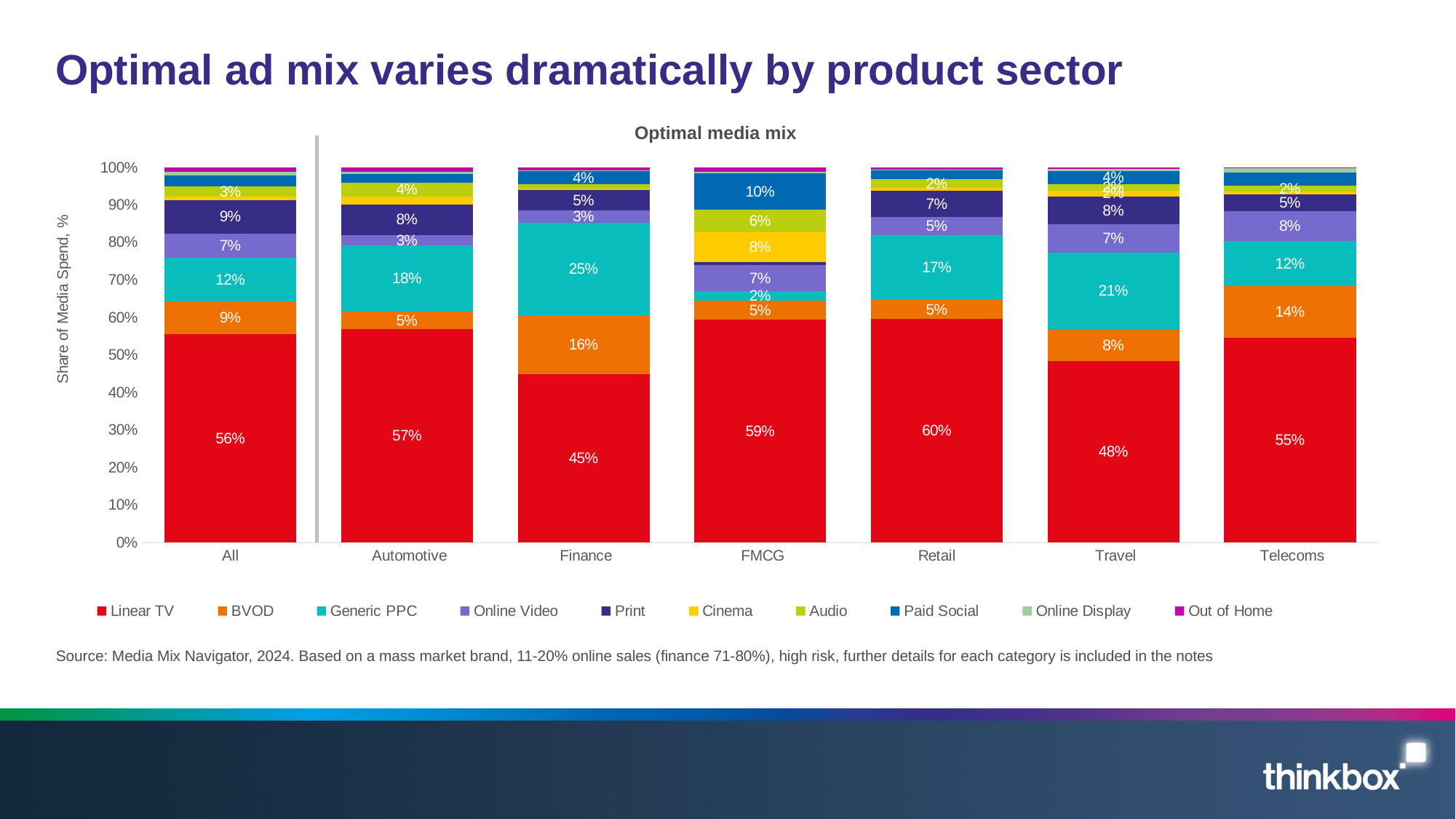
How many series does the legend list? 10 What kind of chart is shown on the slide? Stacked bar chart Which sector has the highest Linear TV share? Retail Which sector has the lowest Linear TV share? Finance What is the Linear TV share of media spend for the Finance sector? 45% What is the Generic PPC share for the Travel sector? 21% What is the Paid Social share for FMCG? 10% How many percentage points higher is the Generic PPC share for Finance than for All? 13 percentage points Which has a larger BVOD share, Finance or Automotive? Finance How many sectors (categories) are shown on the x axis? 7 What is the BVOD share for Telecoms? 14%